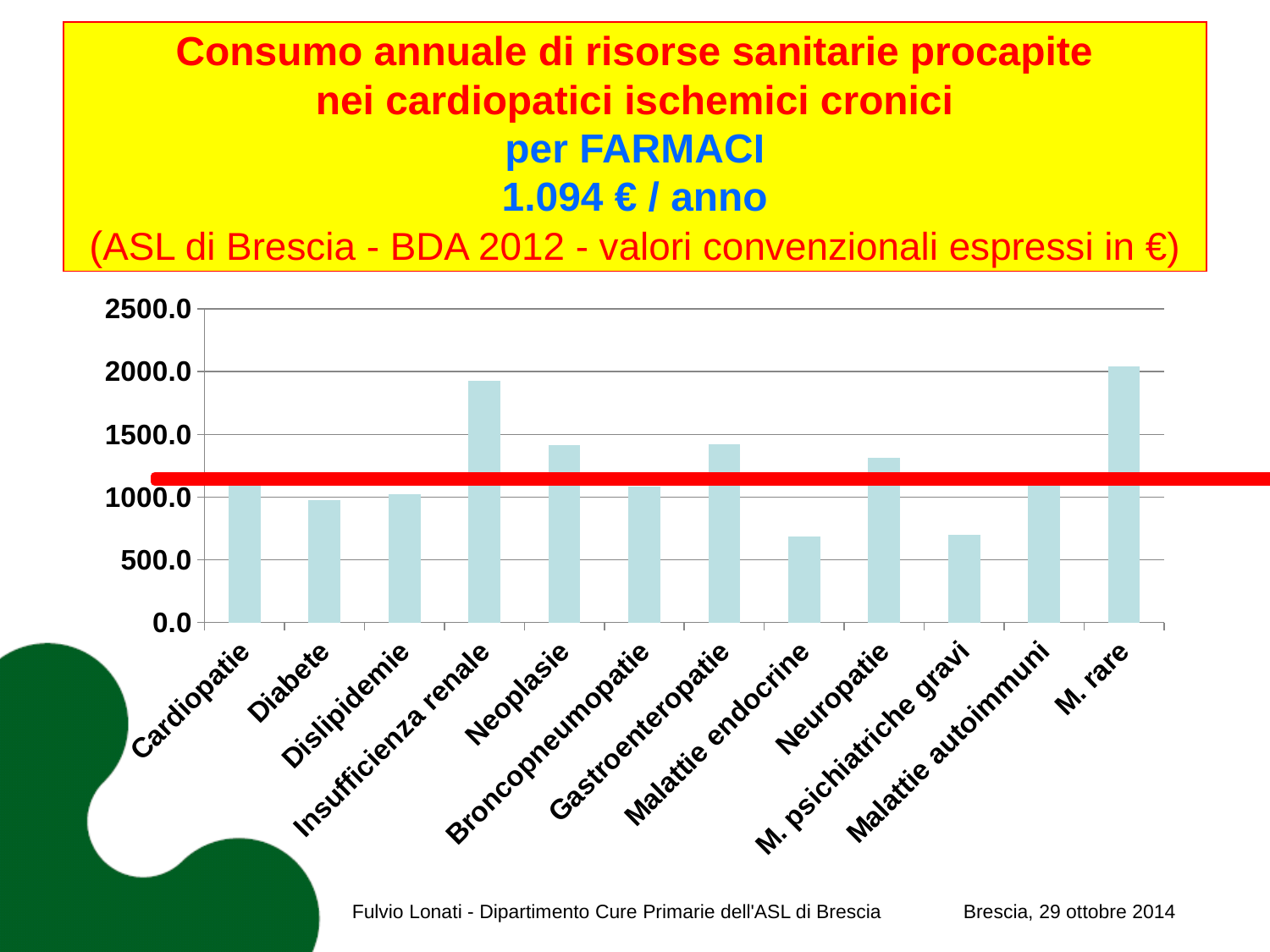
What kind of chart is shown on the slide? bar chart Which is larger, the value for Neoplasie or the value for Malattie endocrine? Neoplasie How many categories are shown on the x axis of the chart? 12 Is the value for Malattie endocrine greater or less than 1000? less Which is larger, the value for Insufficienza renale or the value for Diabete? Insufficienza renale According to the slide title, what is the annual per-capita consumption for FARMACI? 1.094 € / anno Is the value for Neoplasie greater or less than 1000? greater What is the highest value shown on the y axis of the chart? 2500.0 Is the value for Insufficienza renale greater or less than 1500? greater Which category has the highest bar in the chart? M. rare